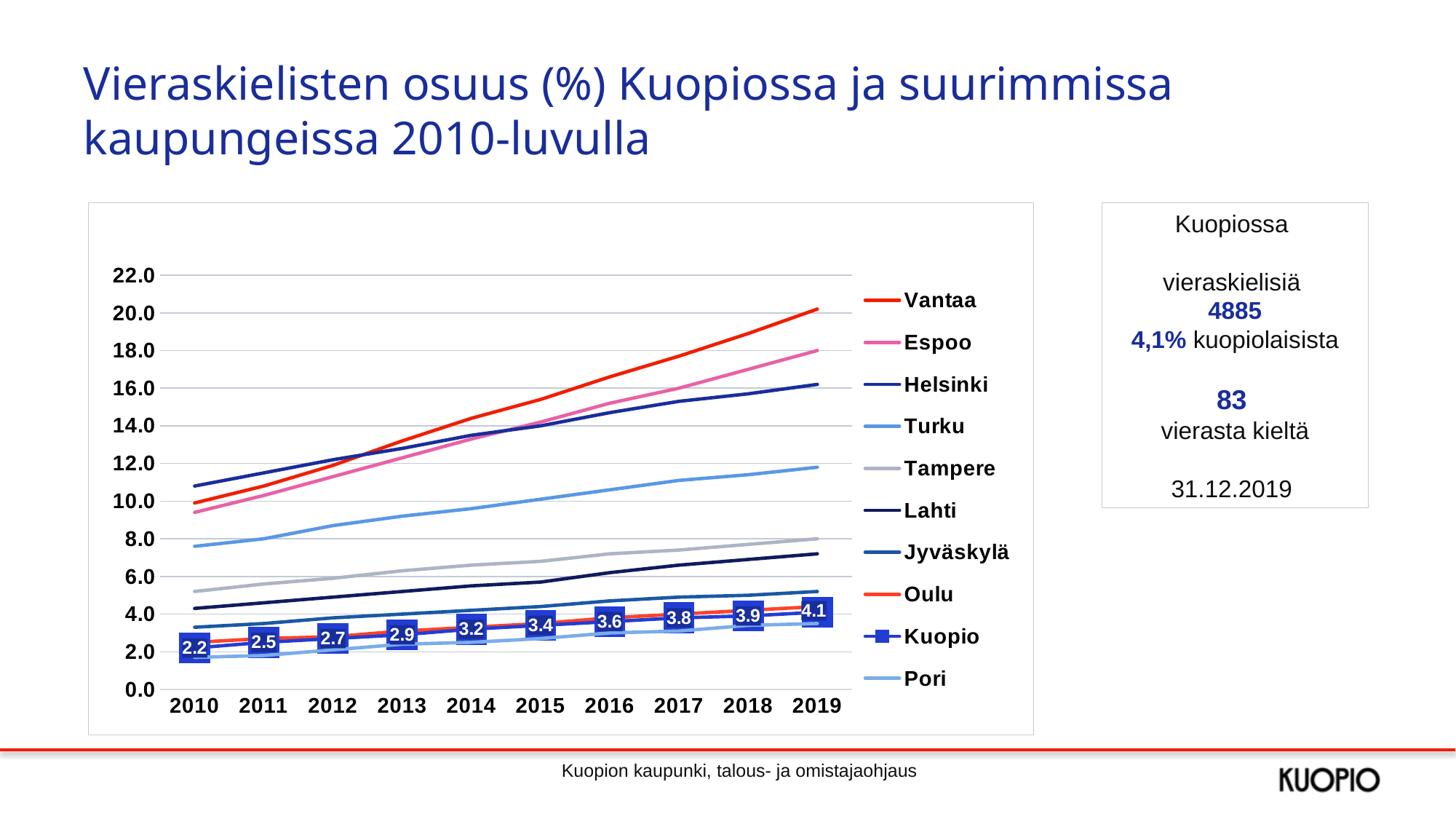
Which city has the lowest value in 2019? Pori In 2019, which is higher, Espoo or Helsinki? Espoo Which city has the highest value in 2010? Helsinki What is the value for Kuopio in 2019? 4.1 How many series does the legend list? 10 Is the value for Lahti in 2019 greater or less than 8.0? less What kind of chart is shown on the slide? line chart By how much did the Kuopio value increase from 2010 to 2019? 1.9 Is the value for Turku in 2019 greater or less than 10.0? greater What is the value for Kuopio in 2015? 3.4 Which city has the highest value in 2019? Vantaa What is the value for Kuopio in 2010? 2.2